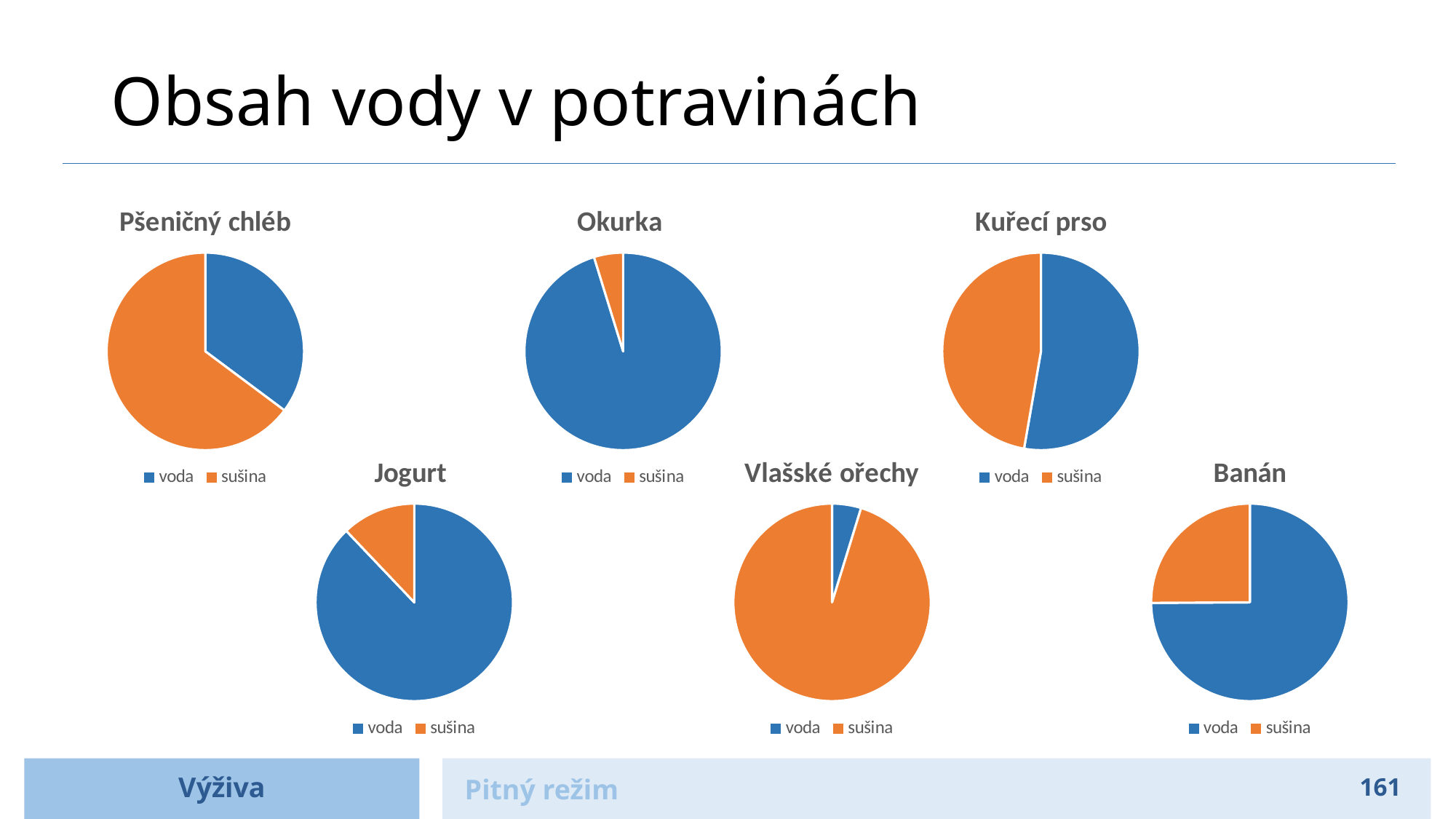
In the "Jogurt" chart, which slice is larger, voda or sušina? voda How many slices does the "Pšeničný chléb" pie chart have? 2 How many series does the legend of the "Banán" chart list? 2 What kind of chart is used for "Okurka"? pie chart In the "Pšeničný chléb" chart, which slice is larger, voda or sušina? sušina How many pie charts are shown on the slide? 6 In the "Vlašské ořechy" chart, which slice is larger, voda or sušina? sušina Across the six pie charts, which food has the smallest voda slice? Vlašské ořechy Across the six pie charts, which food has the largest voda slice? Okurka What colour represents "sušina" in the pie charts? orange